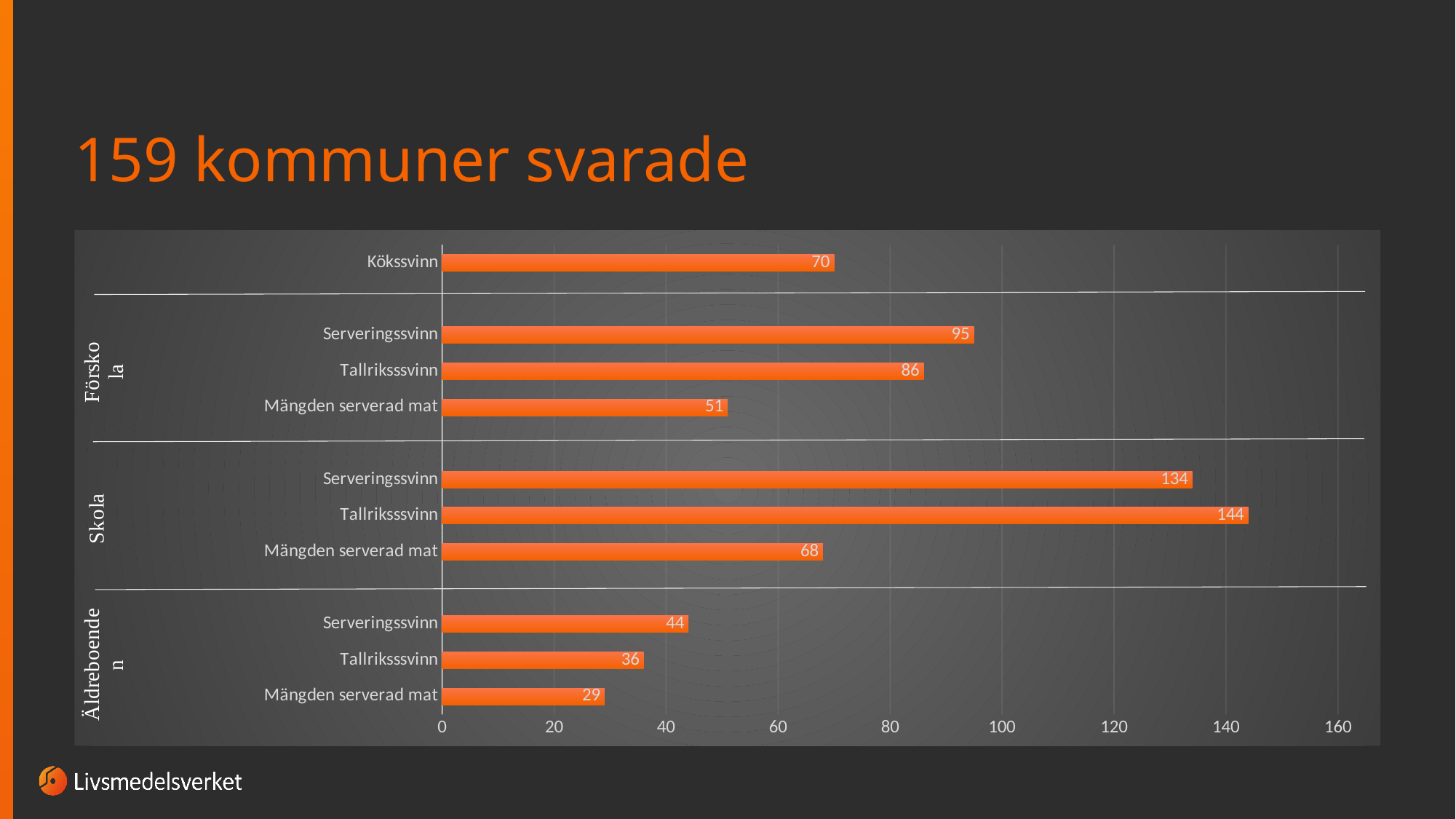
Is the value for Serveringssvinn in the Äldreboenden group greater or less than 60? less What is the title of the slide? 159 kommuner svarade How many bars are plotted on the chart? 10 What type of chart is shown on the slide? Bar chart What value is shown for Serveringssvinn in the Förskola group? 95 What value is shown for Mängden serverad mat in the Äldreboenden group? 29 Which bar has the highest value on the chart? Tallrikssvinn (Skola) What is the difference between Serveringssvinn in the Skola group and Serveringssvinn in the Förskola group? 39 What value is shown for Tallrikssvinn in the Skola group? 144 What value is shown for Kökssvinn? 70 Which bar has the lowest value on the chart? Mängden serverad mat (Äldreboenden) Which is larger: Tallrikssvinn in the Förskola group or Mängden serverad mat in the Skola group? Tallrikssvinn in the Förskola group